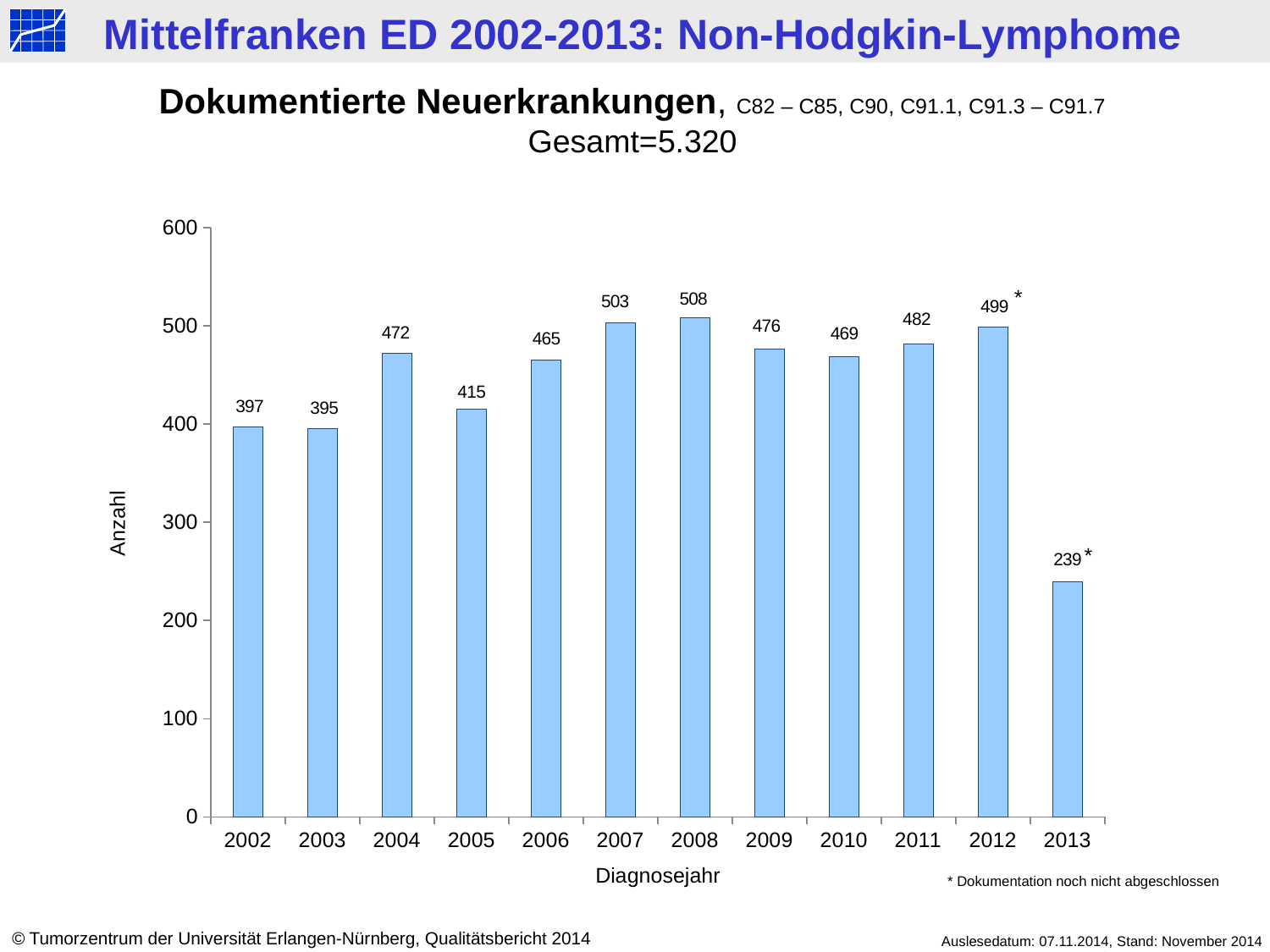
Do the values rise or fall from 2002 to 2004? rise What is the value for 2008? 508 Which year has the lowest value? 2013 What is the label of the x axis? Diagnosejahr What is the difference between the values for 2007 and 2002? 106 How many years are shown on the x axis? 12 What is the value for 2005? 415 What kind of chart is shown? bar chart Which is larger, the value for 2004 or the value for 2009? 2009 Is the value for 2011 greater or less than 400? greater What is the value for 2013? 239 Which year has the highest value? 2008